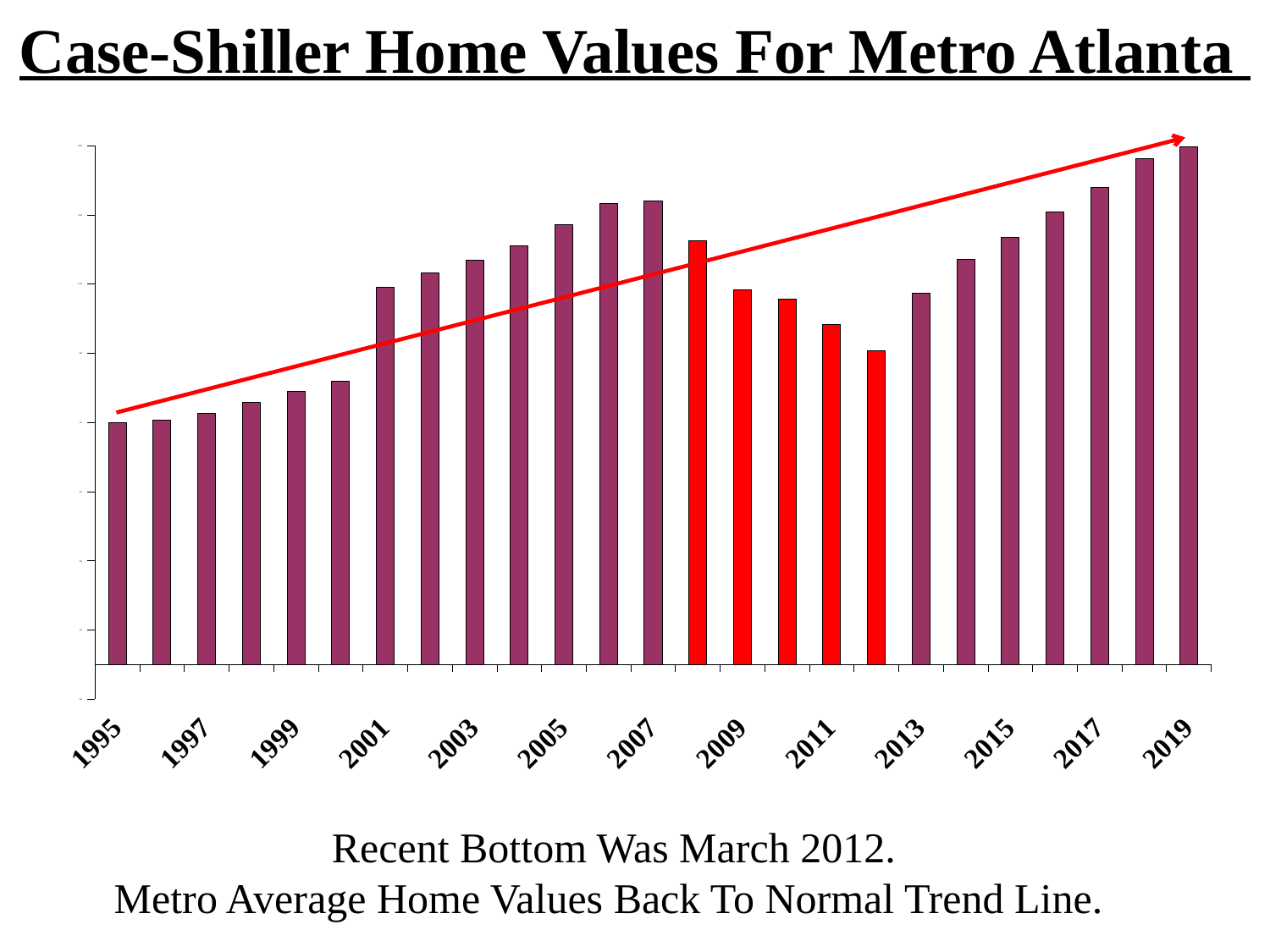
Is the home value for 2007 higher or lower than the value for 2012? Higher Do home values rise or fall from 2012 to 2019? Rise Which year has the highest home value in the chart? 2019 Do home values rise or fall from 2007 to 2012? Fall How many bars (years) are plotted in the chart? 25 How many bars are coloured bright red in the chart? 5 Which year has the larger home value, 2008 or 2012? 2008 What is the title of the slide's chart? Case-Shiller Home Values For Metro Atlanta What kind of chart is shown on the slide? Bar chart Do home values rise or fall from 1995 to 2007? Rise Which years' bars are highlighted in bright red? 2008 to 2012 Which year has the larger home value, 2019 or 2007? 2019